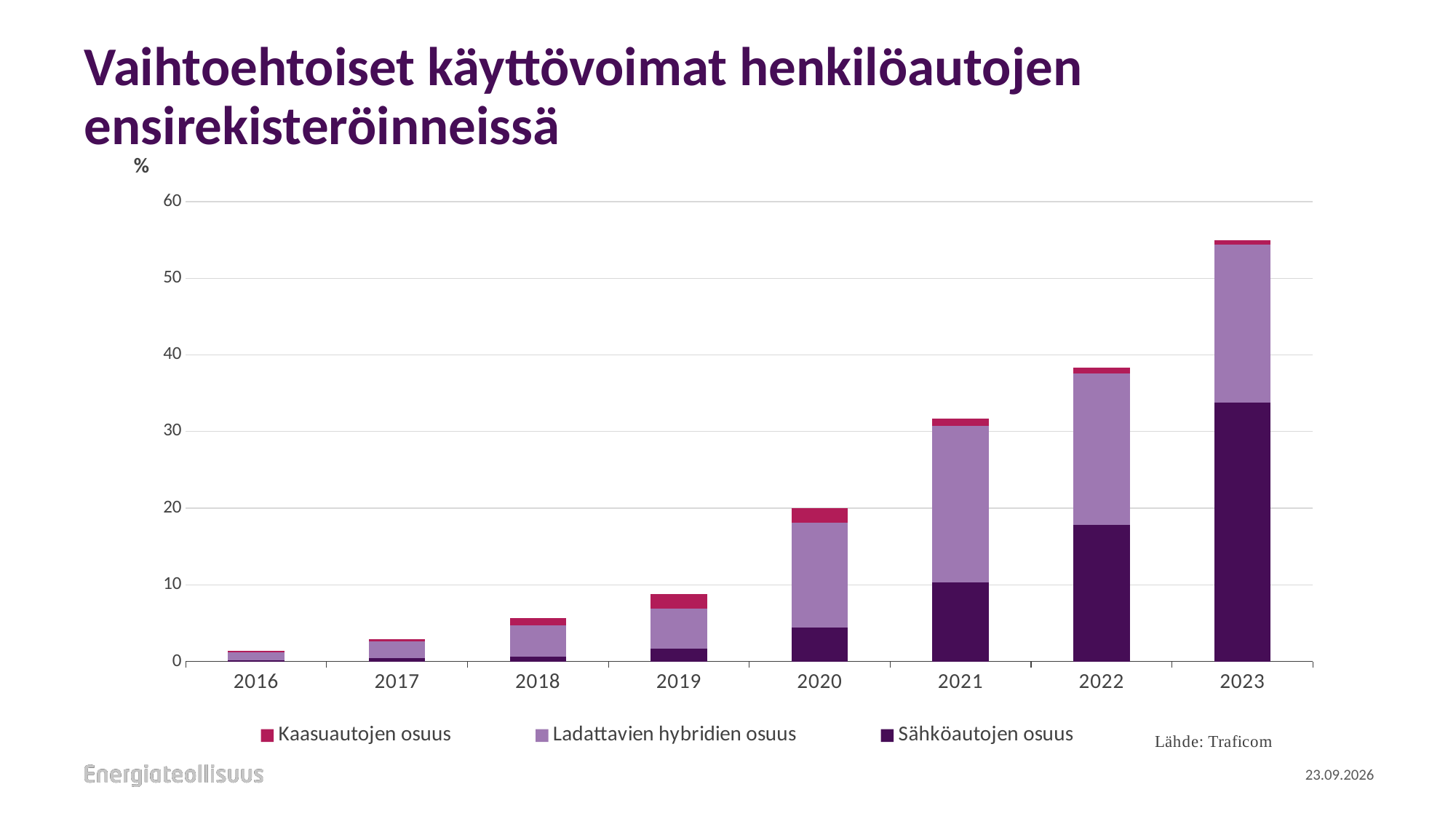
Which year has the highest total bar in the chart? 2023 Is the total bar for 2023 greater or less than 50? greater What is the source cited for the chart's data? Traficom Is the Sähköautojen osuus value for 2023 greater or less than 30? greater Which year has a larger total bar, 2021 or 2022? 2022 Do the total bar values rise or fall from 2016 to 2023? rise Is the total bar for 2019 greater or less than 10? less What kind of chart is shown on the slide? Stacked bar chart How many series does the chart's legend list? 3 How many years are shown on the x axis of the chart? 8 Which year has the lowest total bar in the chart? 2016